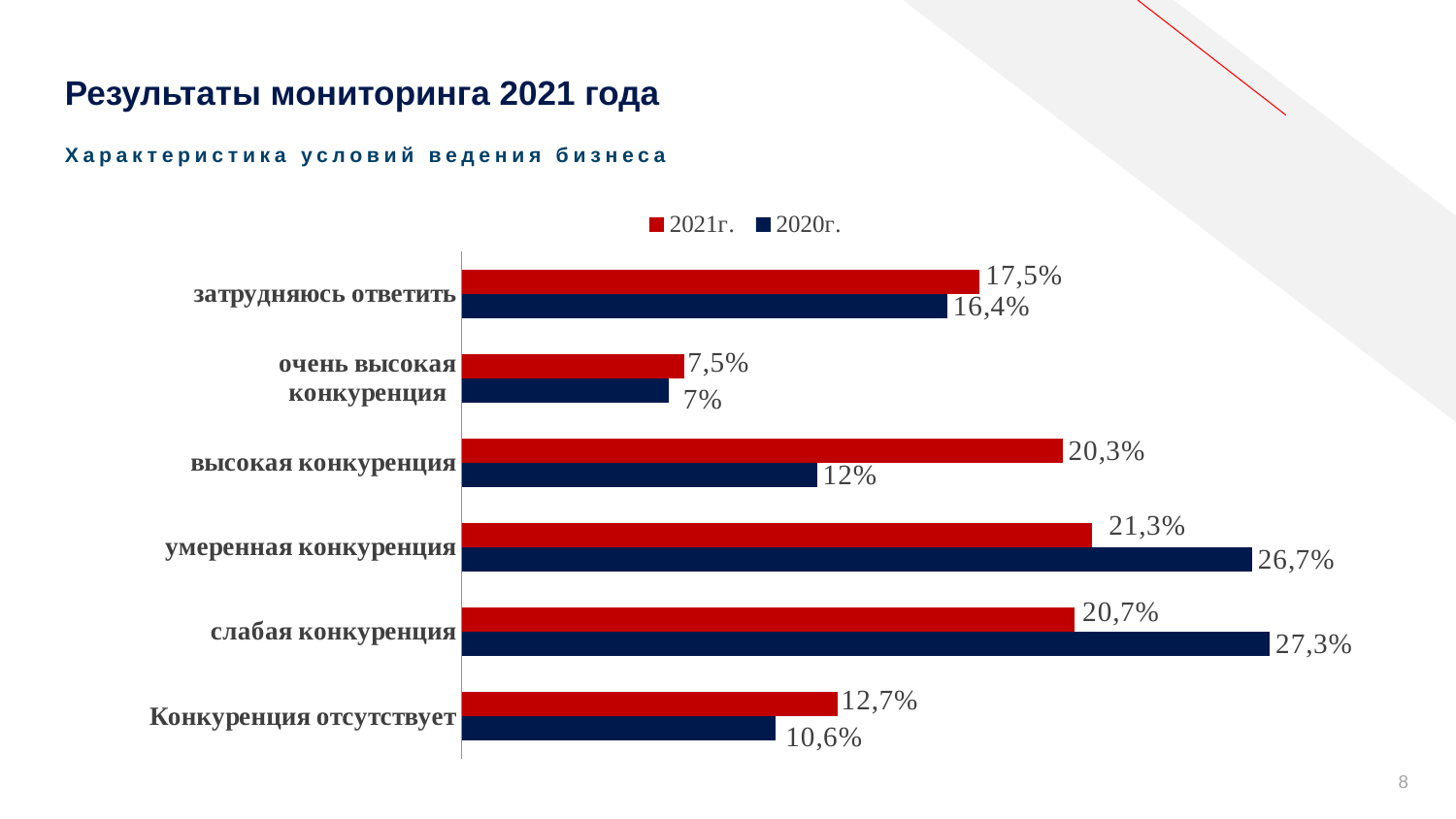
What is the difference between the 2020г. and 2021г. values for «умеренная конкуренция»? 5,4% Which category has the highest 2020г. value? слабая конкуренция Which colour represents the 2021г. series? red Which category has the lowest 2021г. value? очень высокая конкуренция What is the 2021г. value for «высокая конкуренция»? 20,3% How many series does the legend list? 2 What is the 2021г. value for «Конкуренция отсутствует»? 12,7% How many categories are shown on the chart? 6 For «высокая конкуренция», which year has the larger value, 2021г. or 2020г.? 2021г. What type of chart is shown on the slide? bar chart What is the 2020г. value for «очень высокая конкуренция»? 7% What is the 2020г. value for «слабая конкуренция»? 27,3%